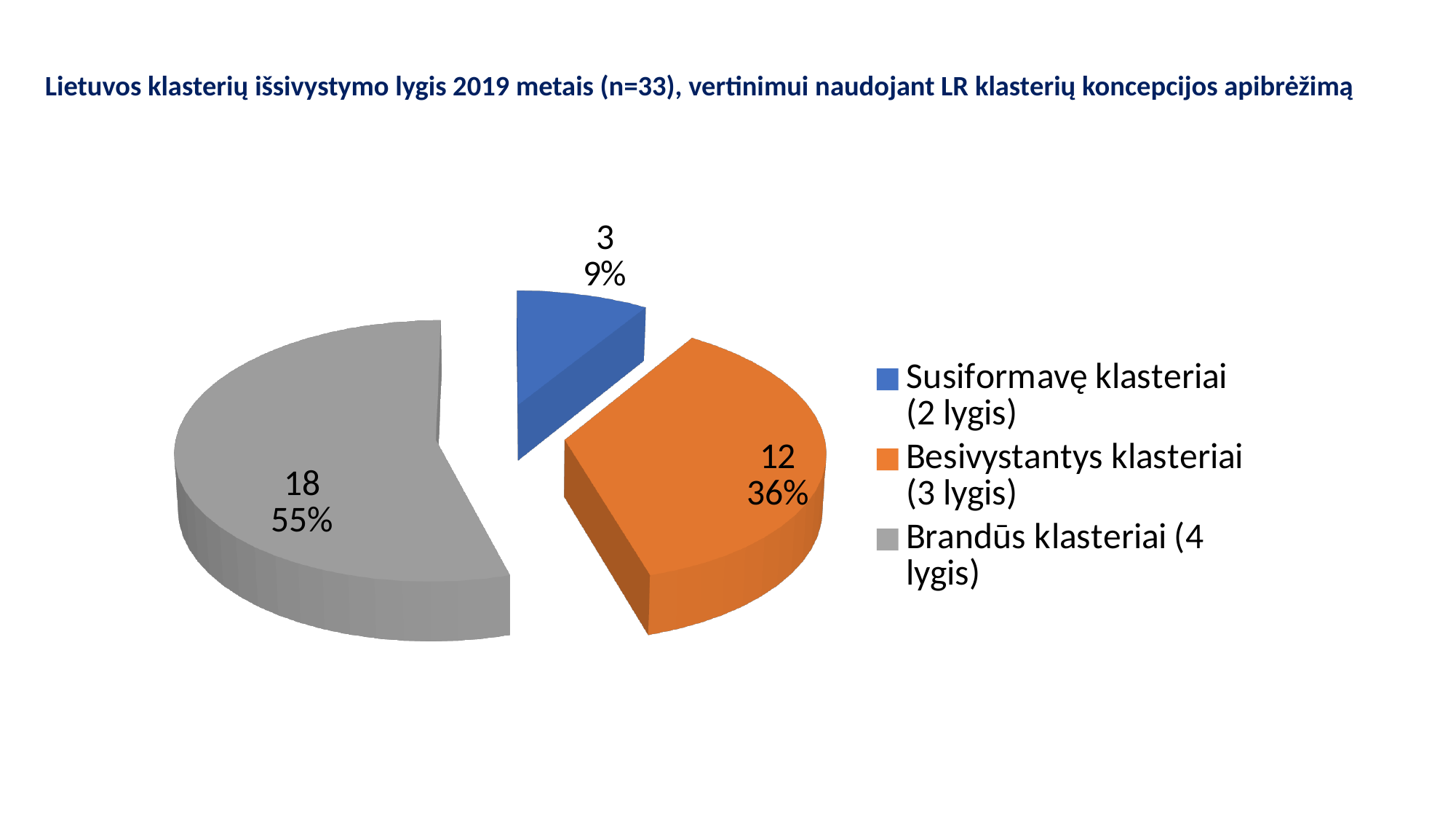
What is the value for Susiformavę klasteriai (2 lygis)? 3 How many slices does the pie chart have? 3 What kind of chart is shown on the slide? pie chart Which is larger, the value for Besivystantys klasteriai (3 lygis) or Susiformavę klasteriai (2 lygis)? Besivystantys klasteriai (3 lygis) What share of the pie does Brandūs klasteriai (4 lygis) represent? 55% What is the value for Brandūs klasteriai (4 lygis)? 18 Which category has the largest slice? Brandūs klasteriai (4 lygis) Which category has the smallest slice? Susiformavę klasteriai (2 lygis) What colour is the slice for Besivystantys klasteriai (3 lygis)? orange What is the value for Besivystantys klasteriai (3 lygis)? 12 What is the difference between the values for Brandūs klasteriai (4 lygis) and Besivystantys klasteriai (3 lygis)? 6 What share of the pie does Susiformavę klasteriai (2 lygis) represent? 9%